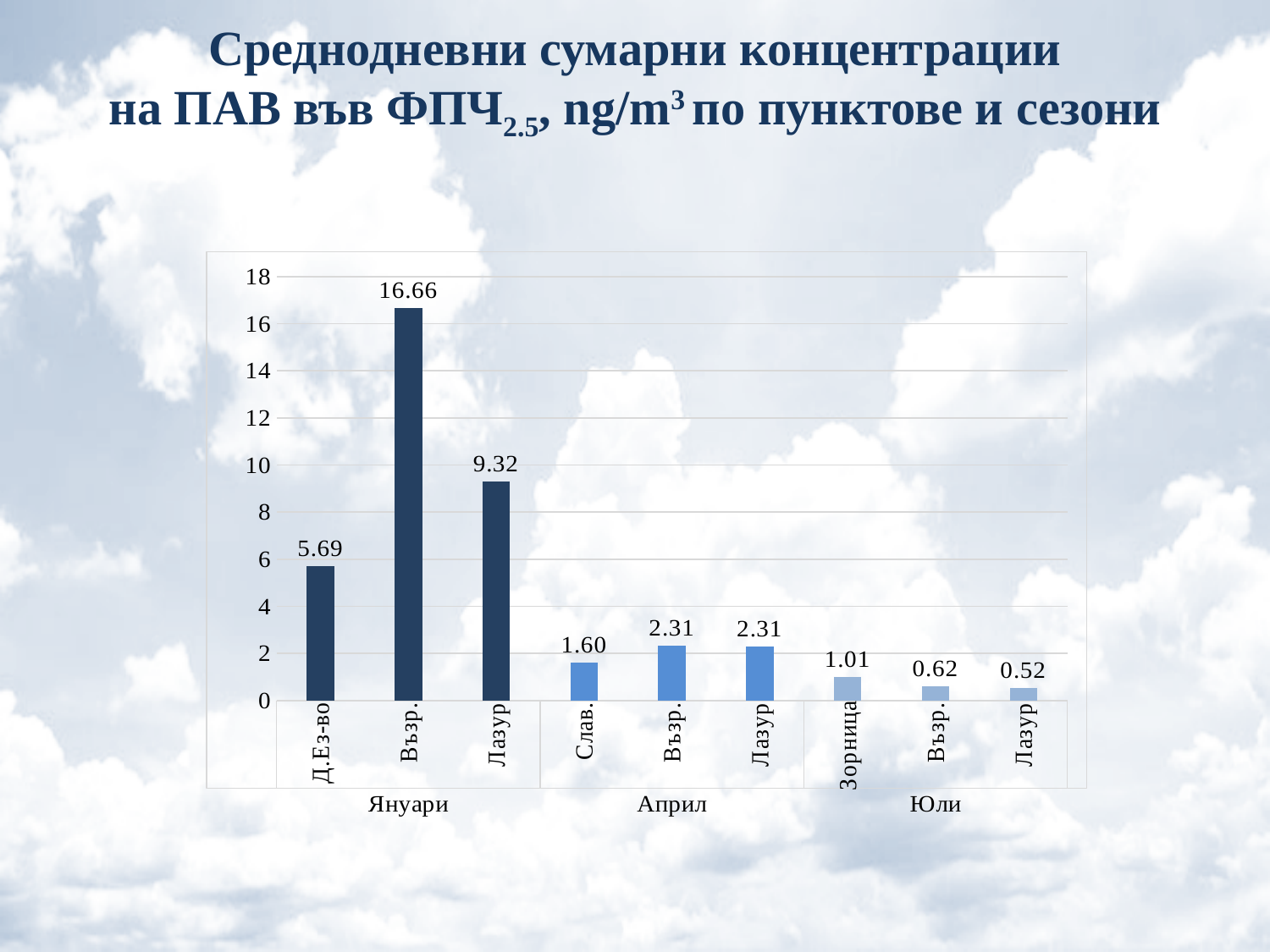
What is the value for Възр. in Януари? 16.66 Which is larger: the value for Д.Ез-во in Януари or the value for Слав. in Април? Д.Ез-во in Януари What is the value for Зорница in Юли? 1.01 What is the value for Лазур in Април? 2.31 What is the difference between the values for Възр. and Лазур in Януари? 7.34 What kind of chart is shown on the slide? bar chart Which bar has the highest value on the chart? Възр. (Януари) Is the value for Лазур in Януари greater or less than 8? greater What is the total of the three values in Юли? 2.15 How many bars are plotted on the chart? 9 How many season groups are shown on the x axis? 3 Which bar has the lowest value on the chart? Лазур (Юли)